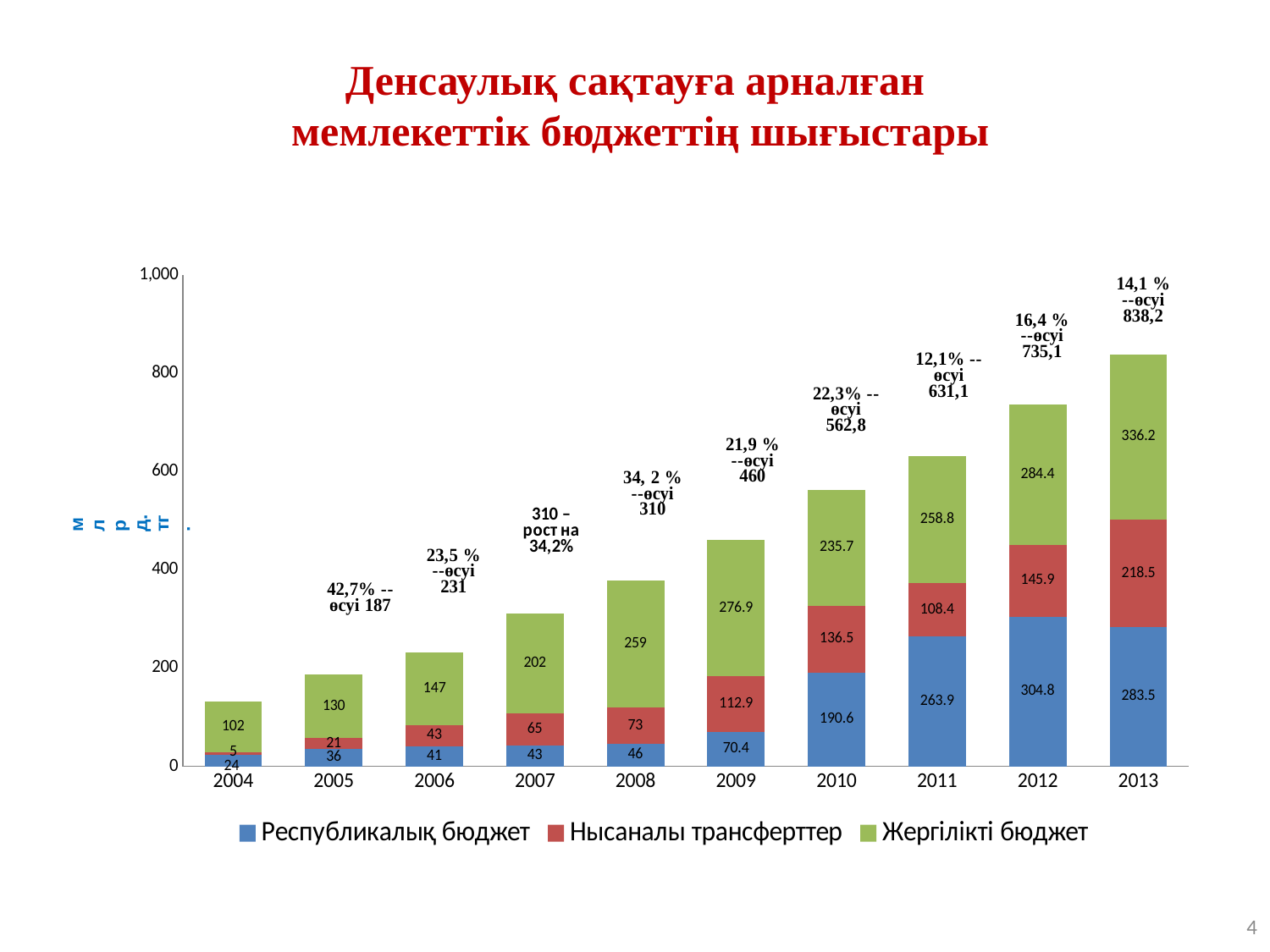
What is the total of the stacked bar for 2013? 838.2 What is the value of Нысаналы трансферттер in 2013? 218.5 In which year is Республикалық бюджет lowest? 2004 Is the total height of the 2010 stacked bar greater or less than 400? greater How many series does the legend list? 3 What is the value of Республикалық бюджет in 2010? 190.6 What is the value of Жергілікті бюджет in 2008? 259 Which year has the larger Республикалық бюджет value, 2012 or 2013? 2012 In which year is Жергілікті бюджет highest? 2013 What kind of chart is shown on the slide? stacked bar chart What is the difference between Жергілікті бюджет in 2013 and in 2012? 51.8 How many years are shown on the x axis? 10